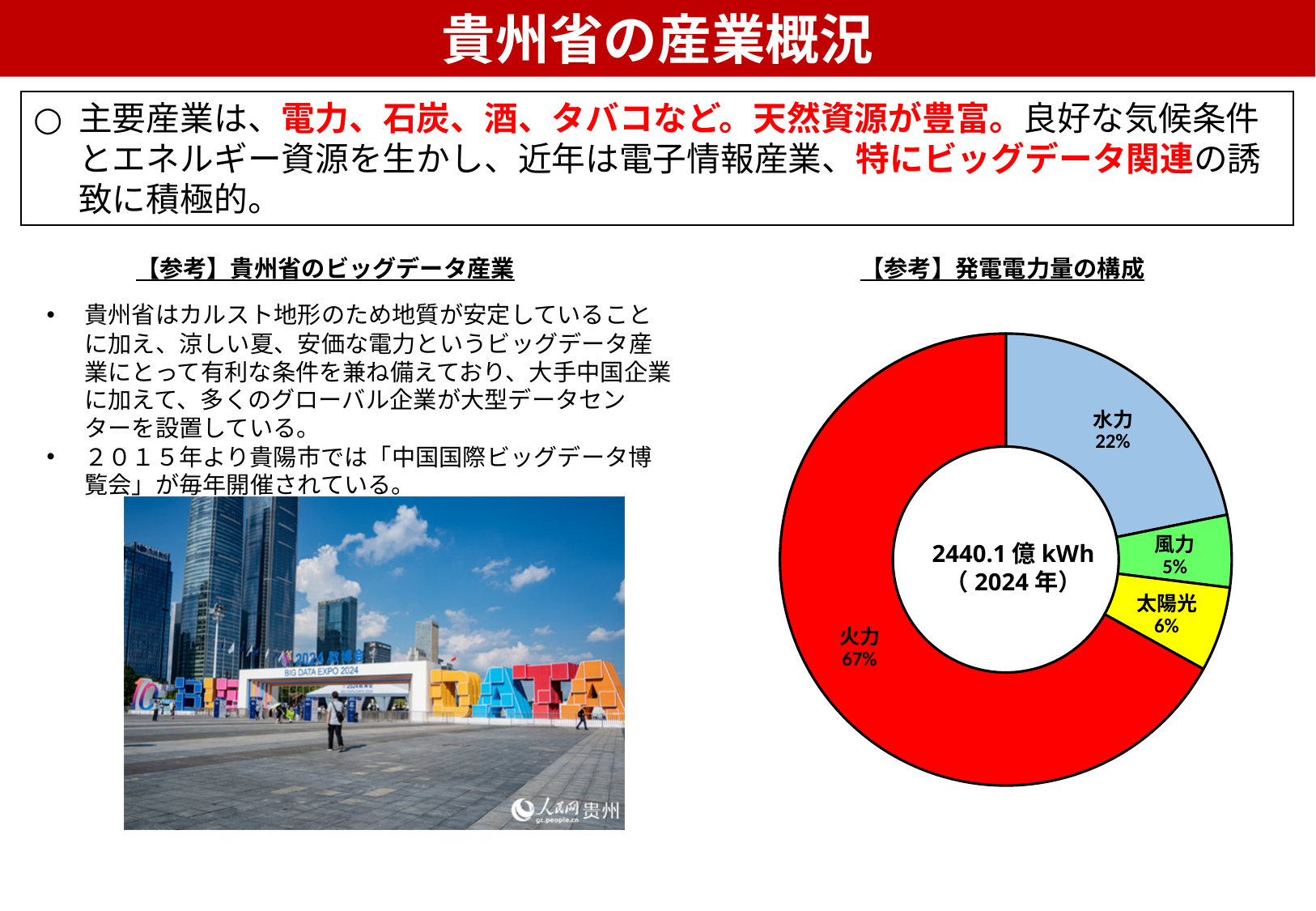
What share of generated electricity does 太陽光 account for in the pie chart? 6% Which has a larger share in the pie chart, 太陽光 or 風力? 太陽光 What share of generated electricity does 風力 account for in the pie chart? 5% What total generated electricity amount is printed in the centre of the pie chart? 2440.1 億 kWh Which category has the smallest share in the pie chart? 風力 What kind of chart is shown under 【参考】発電電力量の構成? Pie chart (donut) Which category has the largest share in the pie chart? 火力 How many categories are shown in the pie chart? 4 What share of generated electricity does 水力 account for in the pie chart? 22% Which year does the pie chart's data refer to, according to the centre label? 2024 年 What is the difference in percentage points between the 火力 share and the 水力 share? 45 percentage points What share of generated electricity does 火力 account for in the pie chart? 67%